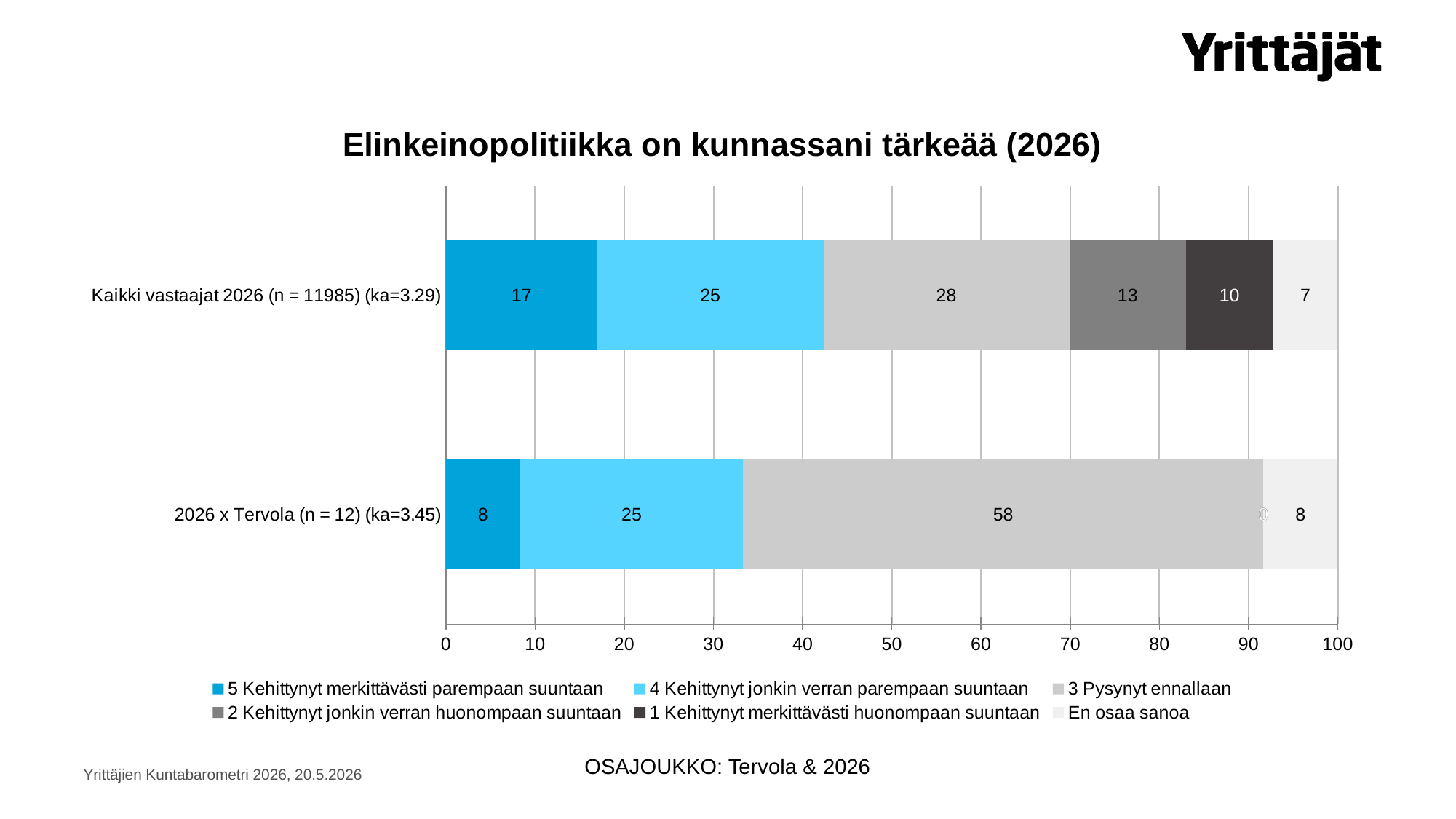
What is the value of '5 Kehittynyt merkittävästi parempaan suuntaan' for 'Kaikki vastaajat 2026 (n = 11985) (ka=3.29)'? 17 How many series does the legend list? 6 Which segment is the largest in the '2026 x Tervola (n = 12) (ka=3.45)' bar? 3 Pysynyt ennallaan What is the value of '1 Kehittynyt merkittävästi huonompaan suuntaan' for 'Kaikki vastaajat 2026 (n = 11985) (ka=3.29)'? 10 What is the value of 'En osaa sanoa' for '2026 x Tervola (n = 12) (ka=3.45)'? 8 How many categories (bars) are shown in the chart? 2 What is the value of '3 Pysynyt ennallaan' for '2026 x Tervola (n = 12) (ka=3.45)'? 58 What kind of chart is shown on the slide? Stacked bar chart What is the title of the chart? Elinkeinopolitiikka on kunnassani tärkeää (2026) Which segment is the smallest in the 'Kaikki vastaajat 2026 (n = 11985) (ka=3.29)' bar? En osaa sanoa What is the difference between the '3 Pysynyt ennallaan' values for '2026 x Tervola' and 'Kaikki vastaajat 2026'? 30 Which category has the larger value for '5 Kehittynyt merkittävästi parempaan suuntaan': 'Kaikki vastaajat 2026' or '2026 x Tervola'? Kaikki vastaajat 2026 (n = 11985) (ka=3.29)